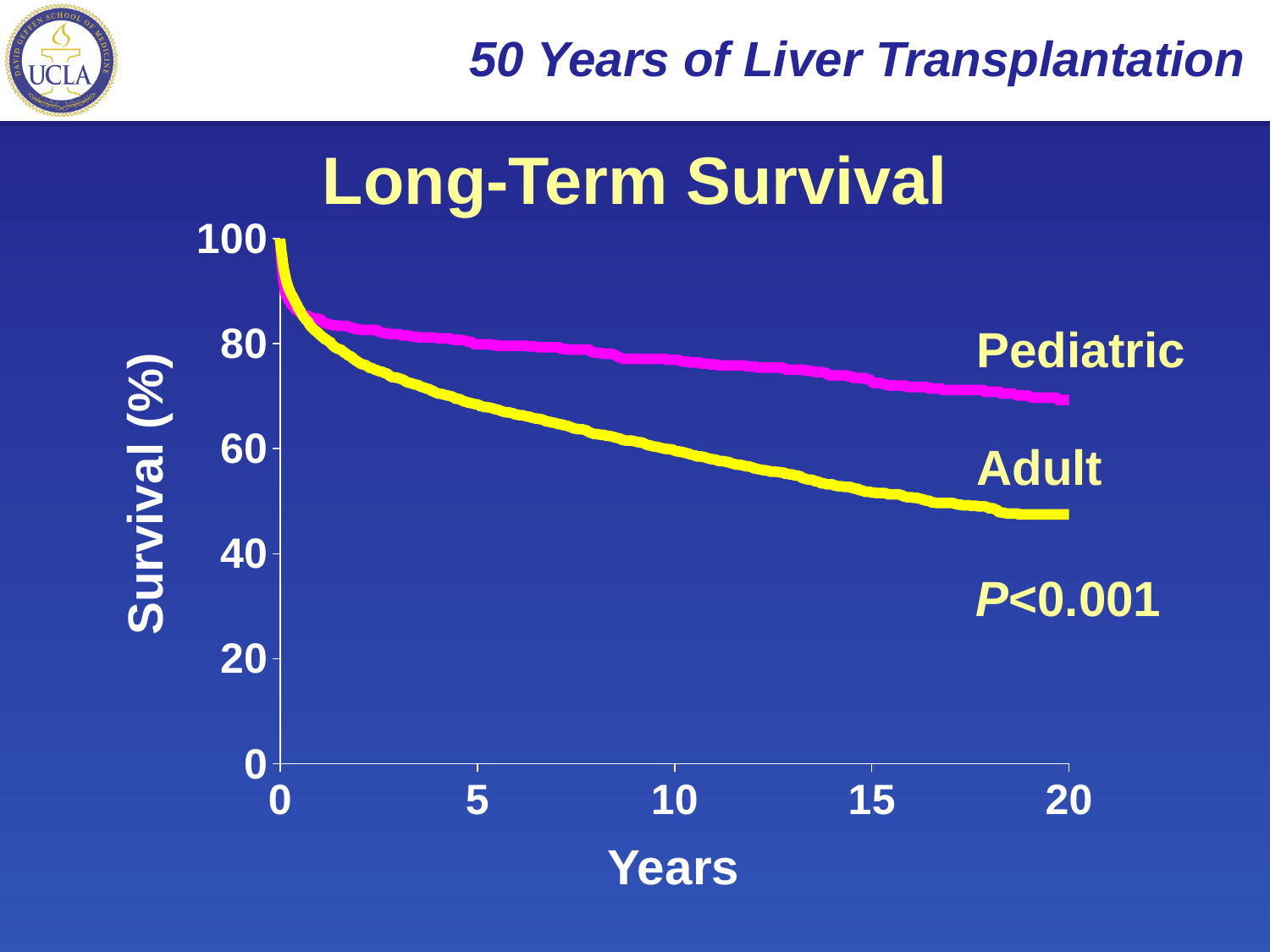
Is the Pediatric survival at 10 years greater or less than 60? greater Is the Pediatric survival at 20 years greater or less than 60? greater Do the survival curves rise or fall as years increase? Fall What kind of chart is shown on the slide? Line chart What is the title of the chart? Long-Term Survival Is the Adult survival at 20 years greater or less than 40? greater Which series has the higher survival at 20 years, Pediatric or Adult? Pediatric How many series are plotted on the Long-Term Survival chart? 2 What are the two series plotted on the Long-Term Survival chart? Pediatric and Adult